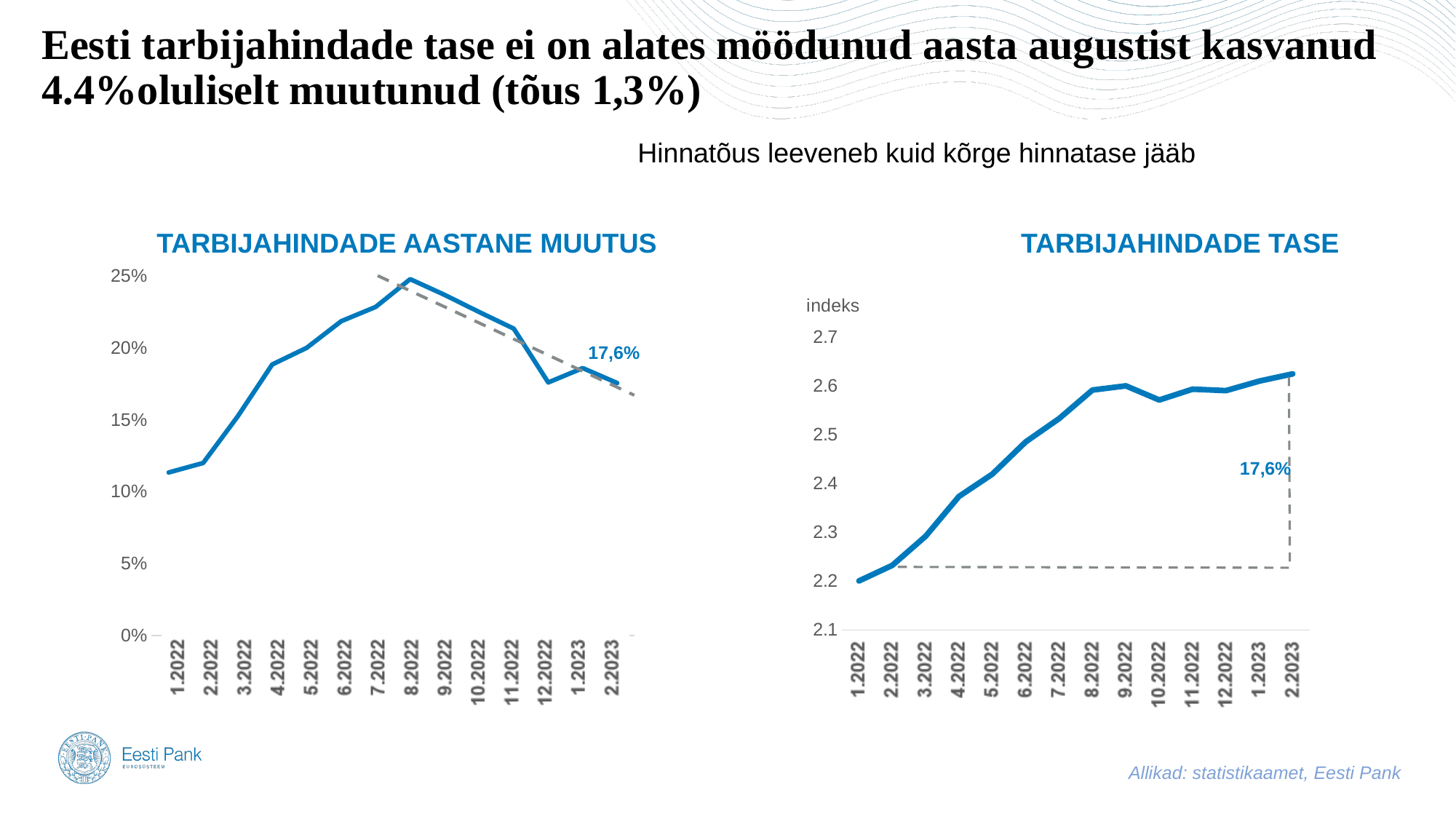
In the 'TARBIJAHINDADE TASE' chart, do the values generally rise or fall from 1.2022 to 2.2023? rise What kind of chart is the 'TARBIJAHINDADE TASE' chart on the right? line chart What kind of chart is the 'TARBIJAHINDADE AASTANE MUUTUS' chart on the left? line chart How many months are shown on the x axis of the 'TARBIJAHINDADE AASTANE MUUTUS' chart? 14 In the 'TARBIJAHINDADE AASTANE MUUTUS' chart, which is larger, the value for 8.2022 or the value for 12.2022? 8.2022 In the 'TARBIJAHINDADE TASE' chart, is the value for 2.2023 greater or less than 2.5? greater What unit label is printed above the y axis of the 'TARBIJAHINDADE TASE' chart? indeks In the 'TARBIJAHINDADE AASTANE MUUTUS' chart, is the value for 8.2022 greater or less than 20%? greater In the 'TARBIJAHINDADE AASTANE MUUTUS' chart, is the value for 1.2022 greater or less than 15%? less In the 'TARBIJAHINDADE AASTANE MUUTUS' chart, which month has the lowest value? 1.2022 In the 'TARBIJAHINDADE AASTANE MUUTUS' chart, which month has the highest value? 8.2022